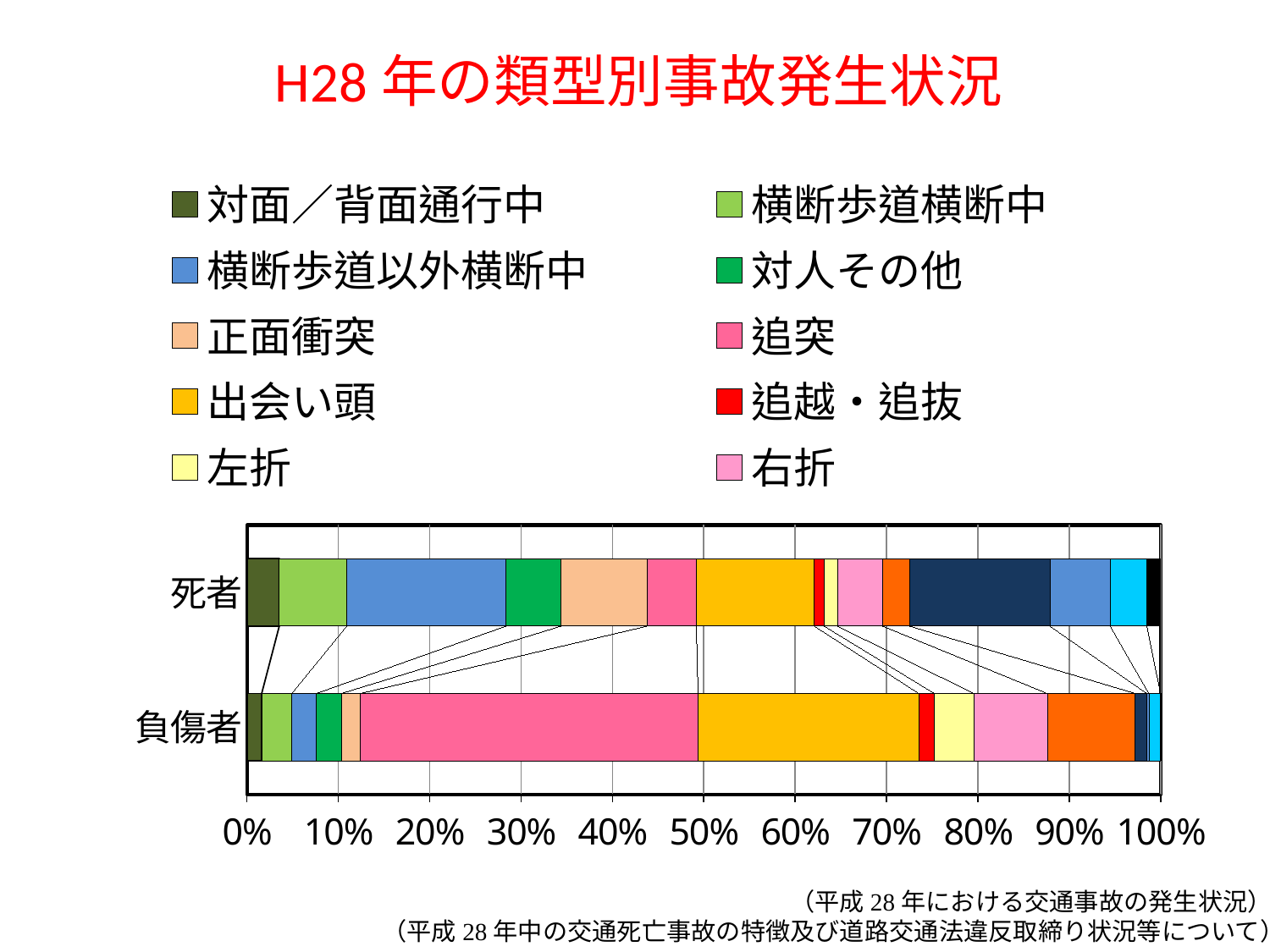
Which bar has the larger share of 追突, 死者 or 負傷者? 負傷者 Is the share of 追突 in the 死者 bar greater or less than 10%? less Which bar has the larger share of 横断歩道以外横断中, 死者 or 負傷者? 死者 What is the title of the slide? H28年の類型別事故発生状況 Is the share of 横断歩道以外横断中 in the 負傷者 bar greater or less than 10%? less How many series does the legend list? 10 Which legend entry is shown in red? 追越・追抜 What kind of chart is shown on the slide? Stacked bar chart Which legend category takes the largest share of the 負傷者 bar? 追突 Is the share of 追突 in the 負傷者 bar greater or less than 30%? greater How many categories (bars) does the chart show? 2